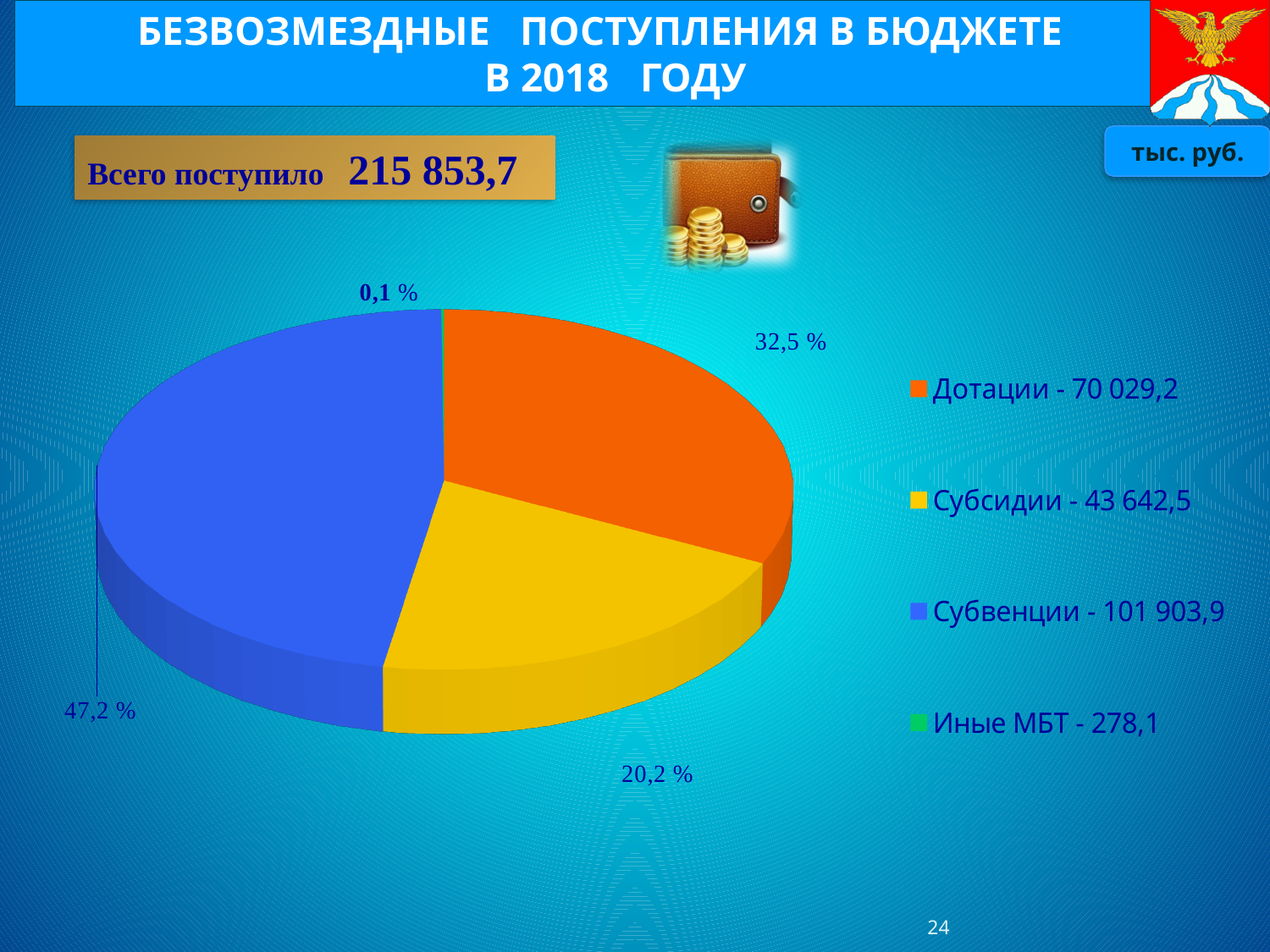
Which is larger, the value for Дотации or the value for Субсидии? Дотации Which category has the smallest slice of the pie chart? Иные МБТ What value is shown in the legend for Иные МБТ? 278,1 What type of chart is shown on the slide? pie chart How many slices does the pie chart have? 4 Which category has the largest slice of the pie chart? Субвенции What is the difference between the values for Субвенции and Дотации? 31 874,7 What value is shown in the legend for Субвенции? 101 903,9 How many entries does the legend of the pie chart list? 4 What value is shown in the legend for Субсидии? 43 642,5 What value is shown in the legend for Дотации? 70 029,2 What share of the pie does Субвенции account for? 47,2 %